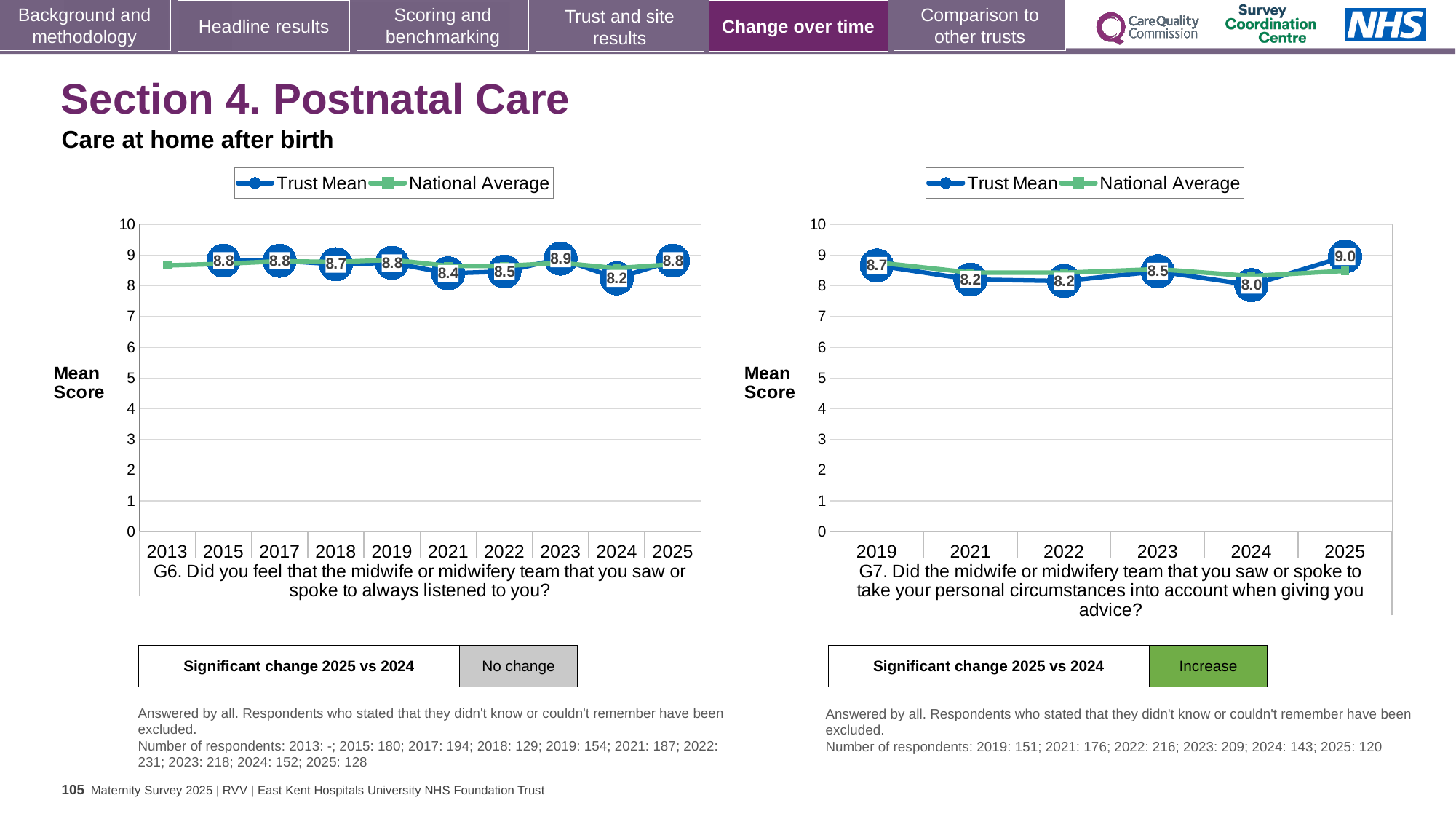
In the G6 chart on the left, which year has the lowest Trust Mean? 2024 In the G7 chart on the right, what is the difference between the Trust Mean for 2025 and 2024? 1.0 In the G7 chart on the right, what is the Trust Mean for 2025? 9.0 In the G6 chart on the left, what is the Trust Mean for 2025? 8.8 What kind of chart is the G7 chart on the right? Line chart In the G6 chart on the left, which year has the highest Trust Mean? 2023 In the G6 chart on the left, what is the difference between the Trust Mean for 2023 and 2024? 0.7 In the G6 chart on the left, what is the Trust Mean for 2024? 8.2 How many series does the legend of the G6 chart on the left list? 2 How many years are shown on the x axis of the G7 chart on the right? 6 In the G7 chart on the right, is the Trust Mean for 2019 larger or smaller than the Trust Mean for 2021? larger In the G7 chart on the right, which year has the lowest Trust Mean? 2024